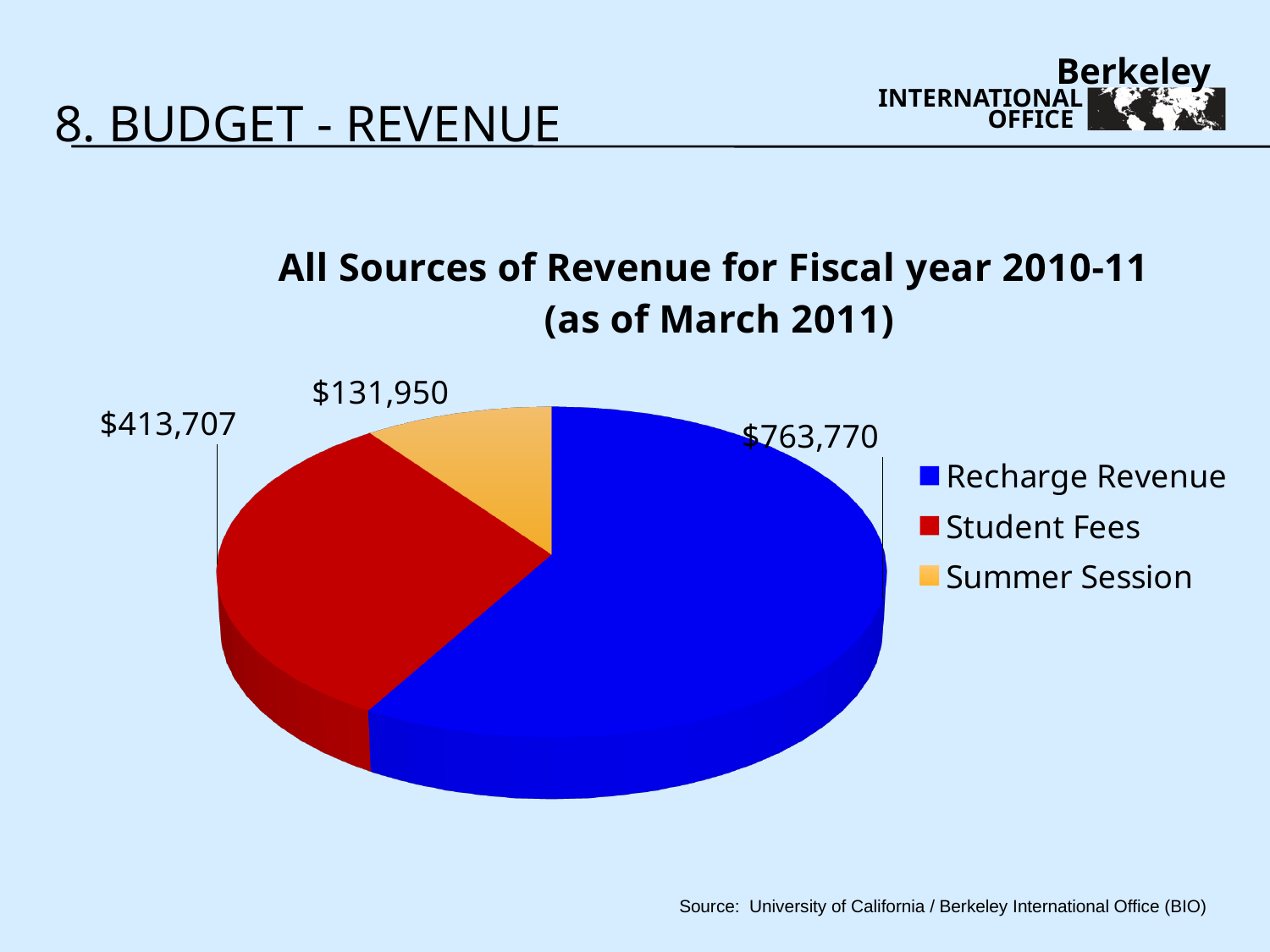
Which revenue source has the smallest value? Summer Session What is the total revenue across all three sources? $1,309,427 What is the revenue value for Summer Session? $131,950 What is the revenue value for Recharge Revenue? $763,770 What is the revenue value for Student Fees? $413,707 Which is larger, Student Fees or Summer Session? Student Fees What type of chart is shown on the slide? Pie chart What is the difference between Student Fees and Summer Session? $281,757 What is the title of the chart? All Sources of Revenue for Fiscal year 2010-11 (as of March 2011) What is the difference between Recharge Revenue and Student Fees? $350,063 Which revenue source has the largest value? Recharge Revenue How many revenue sources are shown in the pie chart? 3